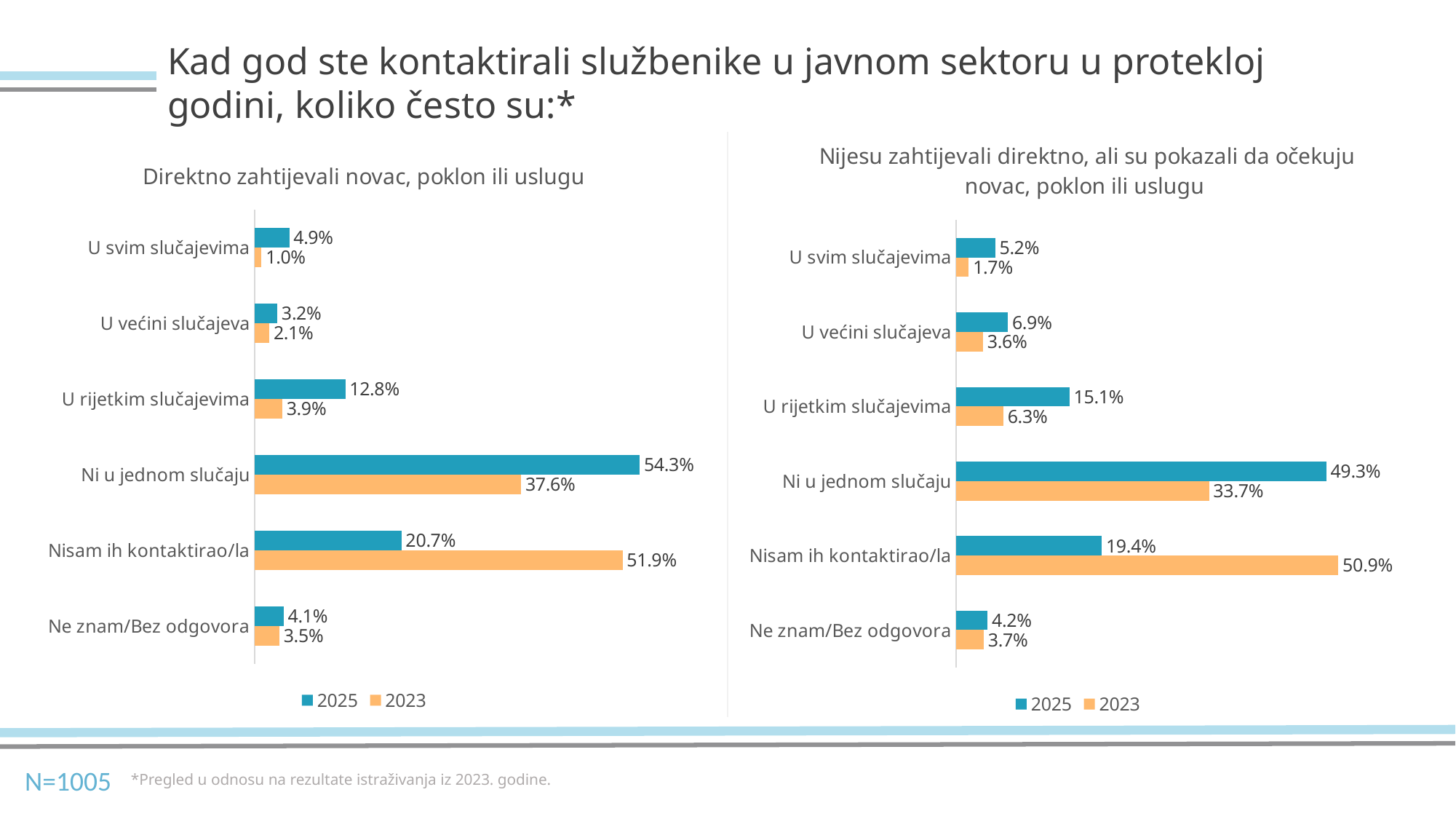
In the left chart 'Direktno zahtijevali novac, poklon ili uslugu', what is the 2023 value for 'Nisam ih kontaktirao/la'? 51.9% In the right chart 'Nijesu zahtijevali direktno...', what is the 2023 value for 'Ni u jednom slučaju'? 33.7% In the right chart 'Nijesu zahtijevali direktno, ali su pokazali da očekuju novac, poklon ili uslugu', what is the 2025 value for 'U rijetkim slučajevima'? 15.1% In the left chart 'Direktno zahtijevali novac, poklon ili uslugu', which category has the highest 2025 value? Ni u jednom slučaju In the left chart 'Direktno zahtijevali novac, poklon ili uslugu', which is larger for 'U rijetkim slučajevima': the 2025 value or the 2023 value? 2025 How many categories are shown in the right chart 'Nijesu zahtijevali direktno...'? 6 In the right chart 'Nijesu zahtijevali direktno...', what is the difference between the 2023 and 2025 values for 'Nisam ih kontaktirao/la'? 31.5% What type of chart is the left chart 'Direktno zahtijevali novac, poklon ili uslugu'? Bar chart How many series does the legend of the left chart 'Direktno zahtijevali novac, poklon ili uslugu' list? 2 In the left chart 'Direktno zahtijevali novac, poklon ili uslugu', what is the 2025 value for 'Ni u jednom slučaju'? 54.3% In the right chart 'Nijesu zahtijevali direktno...', which category has the lowest 2023 value? U svim slučajevima In the left chart 'Direktno zahtijevali novac, poklon ili uslugu', what is the difference between the 2025 and 2023 values for 'Ni u jednom slučaju'? 16.7%